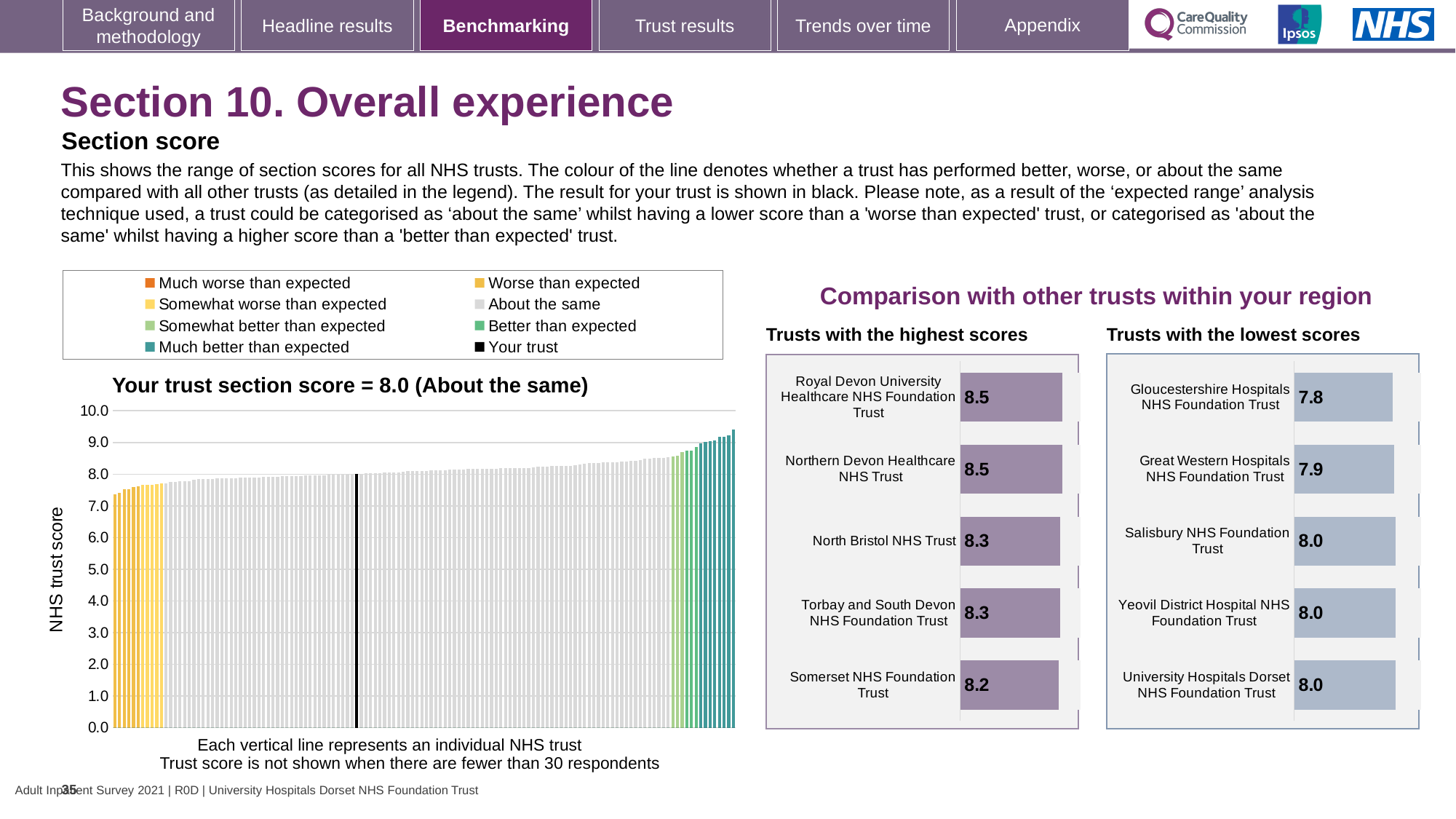
What kind of chart is the 'Your trust section score' chart? bar chart How many entries does the legend above the 'Your trust section score' chart list? 8 In the 'Trusts with the highest scores' chart, which trust has the lowest score? Somerset NHS Foundation Trust In the 'Your trust section score' chart, is the value of the rightmost (highest) bar greater or less than 10.0? less In the 'Your trust section score' chart, do the trust scores rise or fall from left to right along the x axis? rise In the 'Trusts with the highest scores' chart, what is the difference between the scores of Royal Devon University Healthcare NHS Foundation Trust and Somerset NHS Foundation Trust? 0.3 In the 'Trusts with the lowest scores' chart, which trust has the lowest score? Gloucestershire Hospitals NHS Foundation Trust In the 'Your trust section score' chart, is the value of the leftmost (lowest) bar greater or less than 7.0? greater In the 'Your trust section score' chart, what is the section score for your trust? 8.0 What is the y-axis label of the 'Your trust section score' chart? NHS trust score In the 'Trusts with the highest scores' chart, what is the score for North Bristol NHS Trust? 8.3 How many trusts are shown in the 'Trusts with the lowest scores' chart? 5